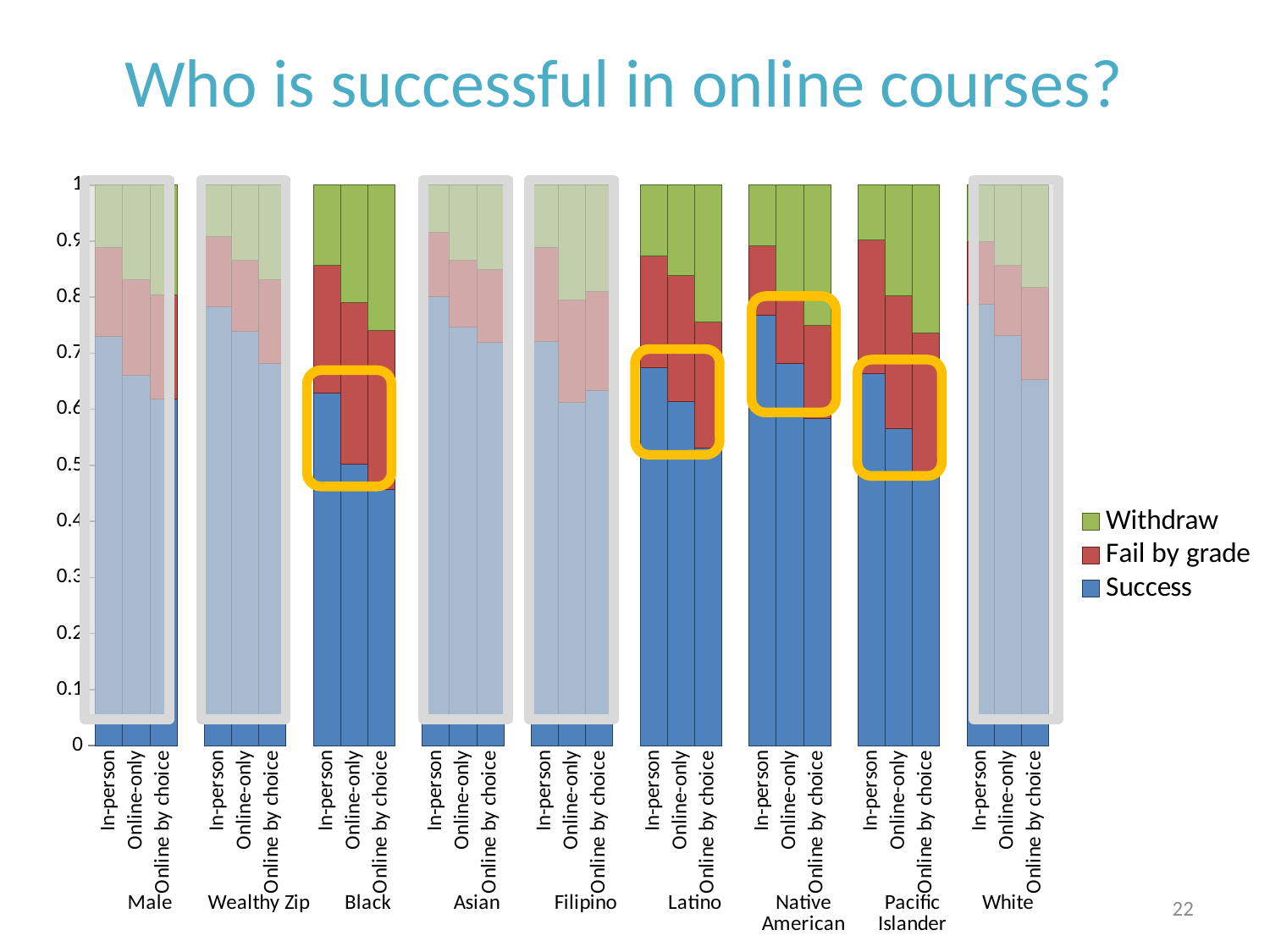
Is the Success value for Native American In-person greater or less than 0.7? greater Is the Success value for Wealthy Zip In-person greater or less than 0.7? greater Is the Success value for Black In-person greater or less than 0.6? greater What is the title of the chart on the slide? Who is successful in online courses? How many series does the legend list? 3 How many demographic groups are shown along the x axis? 9 Which is larger, the Success value for Black In-person or Black Online-only? Black In-person Which colour represents the Withdraw series in the legend? Green What kind of chart is shown on the slide? Stacked bar chart Within the Native American group, does the Success value rise or fall from In-person to Online by choice? fall How many bars are plotted in total across all groups? 27